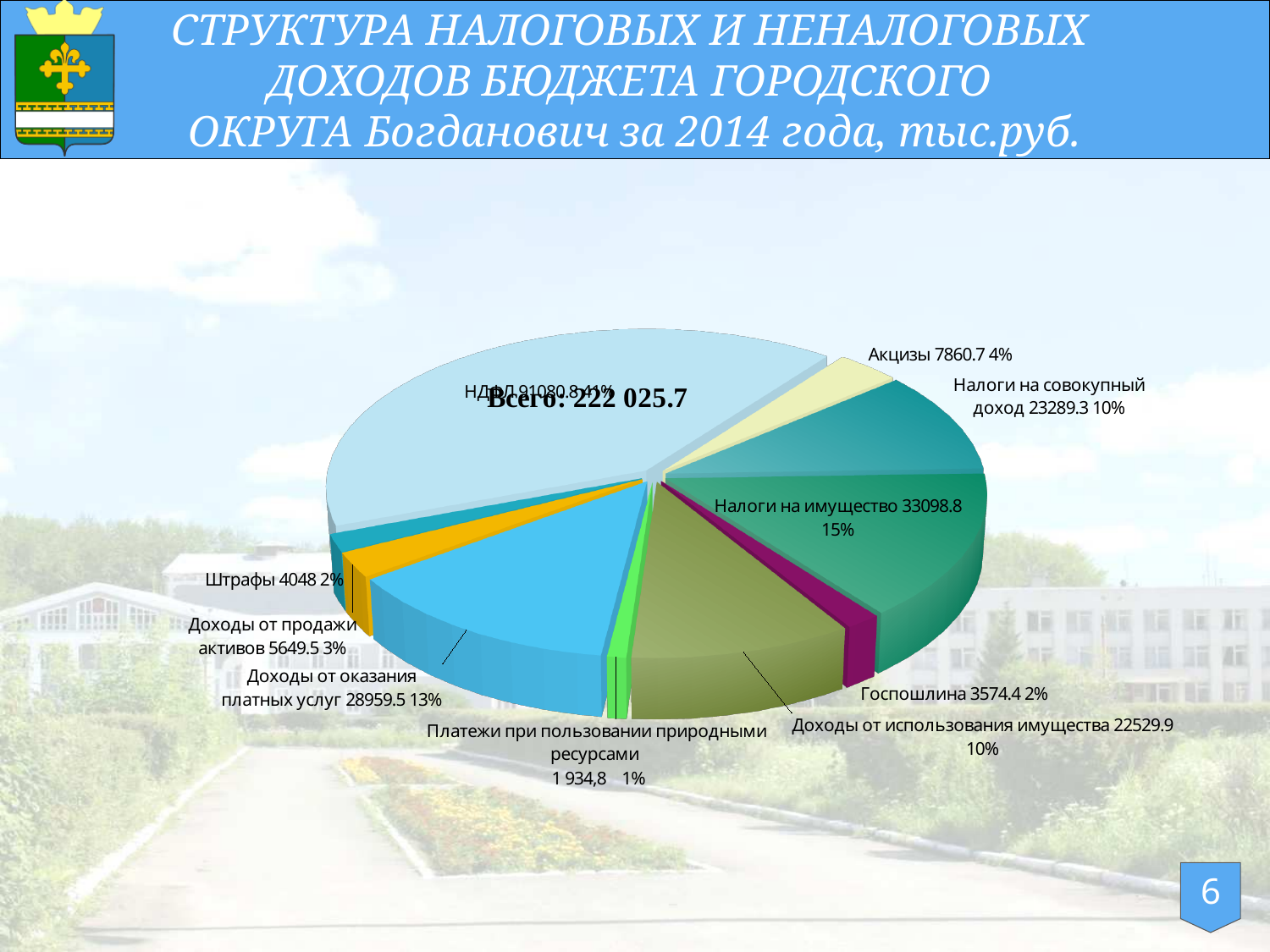
What is the difference between the values for Налоги на имущество and Акцизы? 25238.1 What is the value for Доходы от оказания платных услуг? 28959.5 Which is larger, Налоги на имущество or Доходы от оказания платных услуг? Налоги на имущество What kind of chart is shown on the slide? pie chart What is the value for Штрафы? 4048 Which category has the largest slice of the pie? НДФЛ What share of the pie does Налоги на имущество represent? 15% What is the value for Госпошлина? 3574.4 What share of the pie does Акцизы represent? 4% Which category has the smallest slice of the pie? Платежи при пользовании природными ресурсами How many categories are shown in the pie chart? 10 What is the value for Налоги на имущество? 33098.8